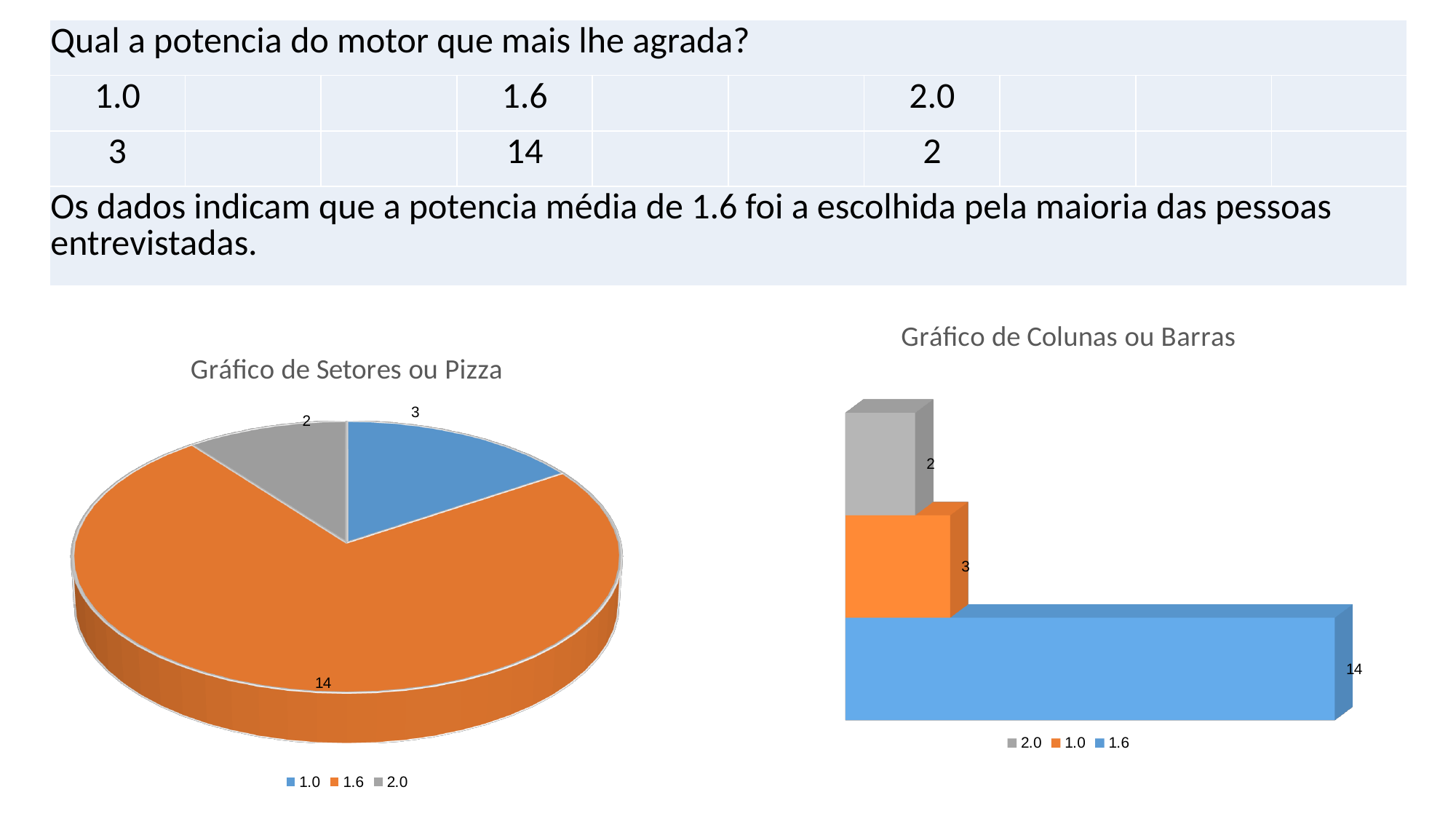
In the 'Gráfico de Colunas ou Barras' chart, what is the value for 2.0? 2 How many slices does the 'Gráfico de Setores ou Pizza' chart have? 3 In the 'Gráfico de Setores ou Pizza' chart, what is the value for 1.0? 3 In the 'Gráfico de Setores ou Pizza' chart, which category has the largest slice? 1.6 In the 'Gráfico de Colunas ou Barras' chart, what is the difference between the values for 1.6 and 1.0? 11 In the 'Gráfico de Setores ou Pizza' chart, what is the total of all slices? 19 In the 'Gráfico de Setores ou Pizza' chart, which is larger, the value for 1.0 or the value for 2.0? 1.0 What kind of chart is the chart on the left of the slide? Pie chart What kind of chart is the chart on the right of the slide? Bar chart In the 'Gráfico de Setores ou Pizza' chart, what is the value for 1.6? 14 In the 'Gráfico de Colunas ou Barras' chart, which category has the smallest value? 2.0 How many entries does the legend of the 'Gráfico de Colunas ou Barras' chart list? 3